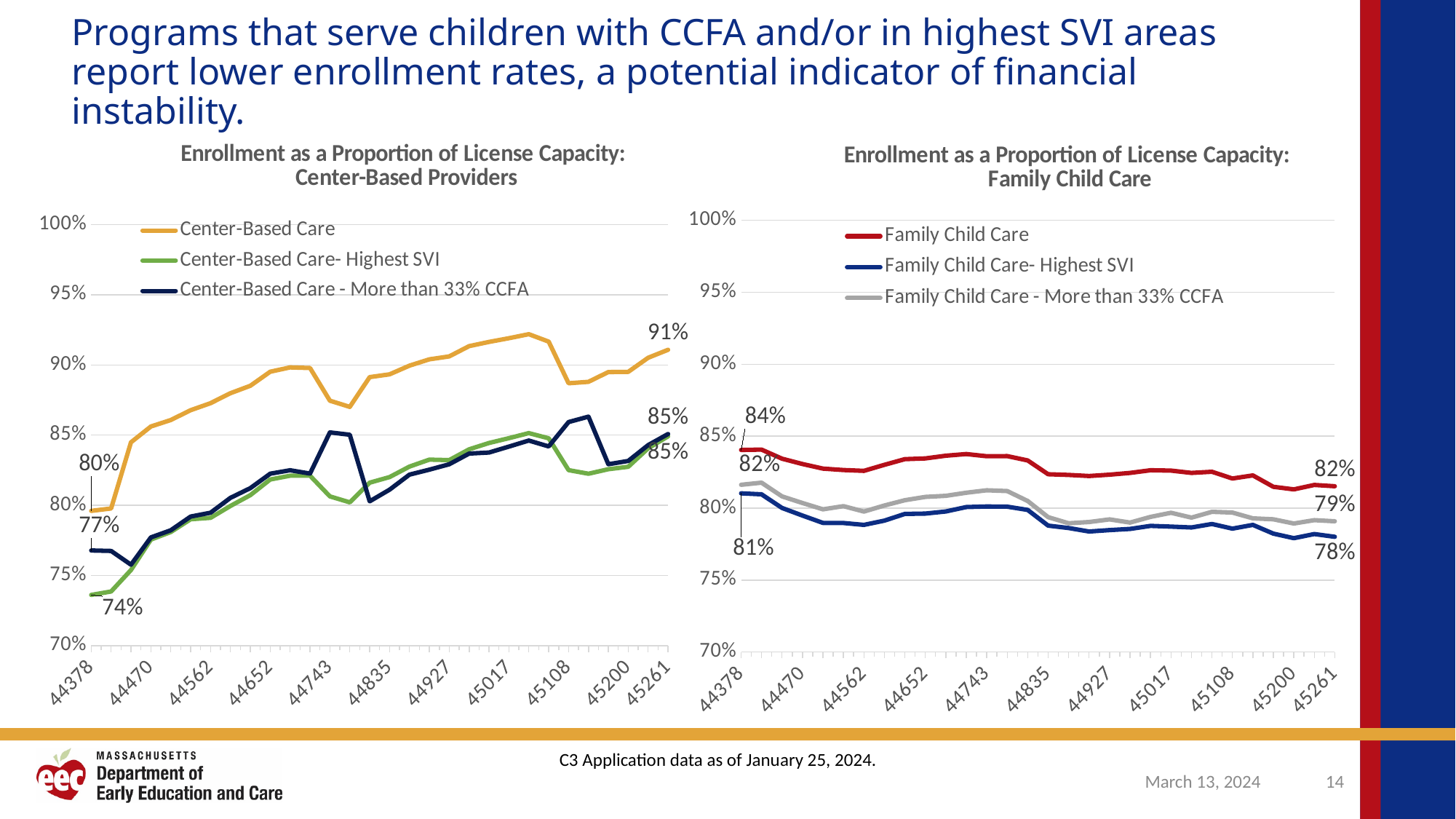
In the Center-Based Providers chart, what is the starting value labeled for the Center-Based Care - Highest SVI series? 74% In the Family Child Care chart, does the Family Child Care series generally rise or fall from left to right? Fall In the Center-Based Providers chart, by how many percentage points did the Center-Based Care series rise from its first labeled value to its last? 11 percentage points In the Family Child Care chart, what is the starting value labeled for the Family Child Care - More than 33% CCFA series? 82% In the Center-Based Providers chart, which series has the higher final value: Center-Based Care or Center-Based Care - Highest SVI? Center-Based Care In the Family Child Care chart, what is the final value shown for the Family Child Care - Highest SVI series? 78% In the Family Child Care chart, what is the difference between the final values of the Family Child Care series and the Family Child Care - Highest SVI series? 4 percentage points In the Center-Based Providers chart, what is the final value shown for the Center-Based Care series? 91% What type of chart is the Center-Based Providers chart? Line chart How many series does the legend of the Family Child Care chart list? 3 In the Center-Based Providers chart, what is the starting value labeled for the Center-Based Care - More than 33% CCFA series? 77% In the Family Child Care chart, what is the final value shown for the Family Child Care series? 82%